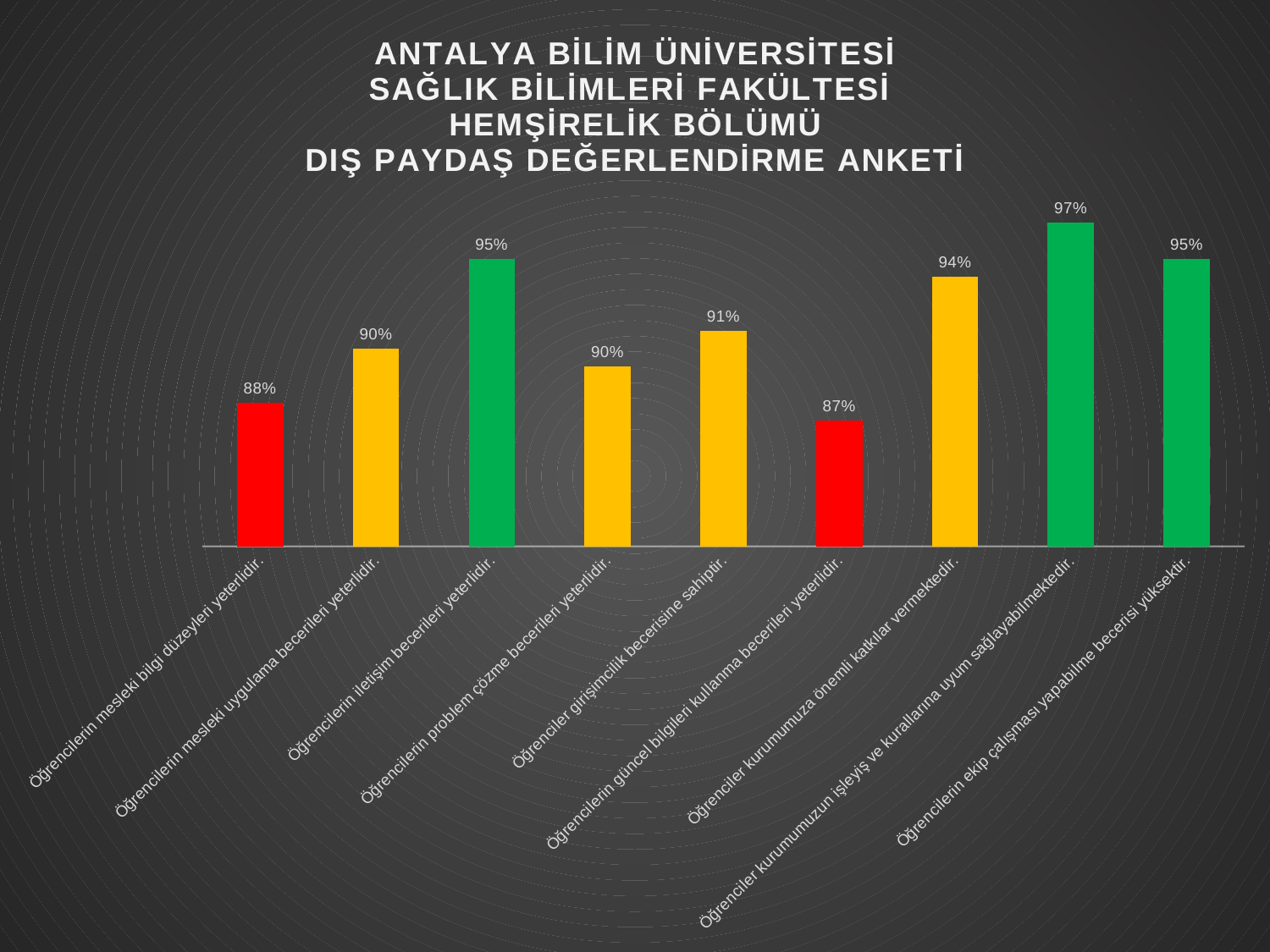
Which is larger: the value for "Öğrenciler girişimcilik becerisine sahiptir." or the value for "Öğrencilerin problem çözme becerileri yeterlidir."? Öğrenciler girişimcilik becerisine sahiptir. What value is shown for "Öğrencilerin mesleki bilgi düzeyleri yeterlidir."? 88% What colour is the bar for "Öğrencilerin güncel bilgileri kullanma becerileri yeterlidir."? Red What value is shown for "Öğrenciler kurumumuza önemli katkılar vermektedir."? 94% Which category has the lowest value? Öğrencilerin güncel bilgileri kullanma becerileri yeterlidir. Which category has the highest value? Öğrenciler kurumumuzun işleyiş ve kurallarına uyum sağlayabilmektedir. How many categories (bars) does the chart show? 9 What is the difference between the highest value (97%) and the lowest value (87%)? 10% What value is shown for "Öğrencilerin iletişim becerileri yeterlidir."? 95% What value is shown for "Öğrenciler girişimcilik becerisine sahiptir."? 91% What kind of chart is shown on the slide? Bar chart What is the difference between the values for "Öğrenciler kurumumuza önemli katkılar vermektedir." and "Öğrencilerin mesleki bilgi düzeyleri yeterlidir."? 6%